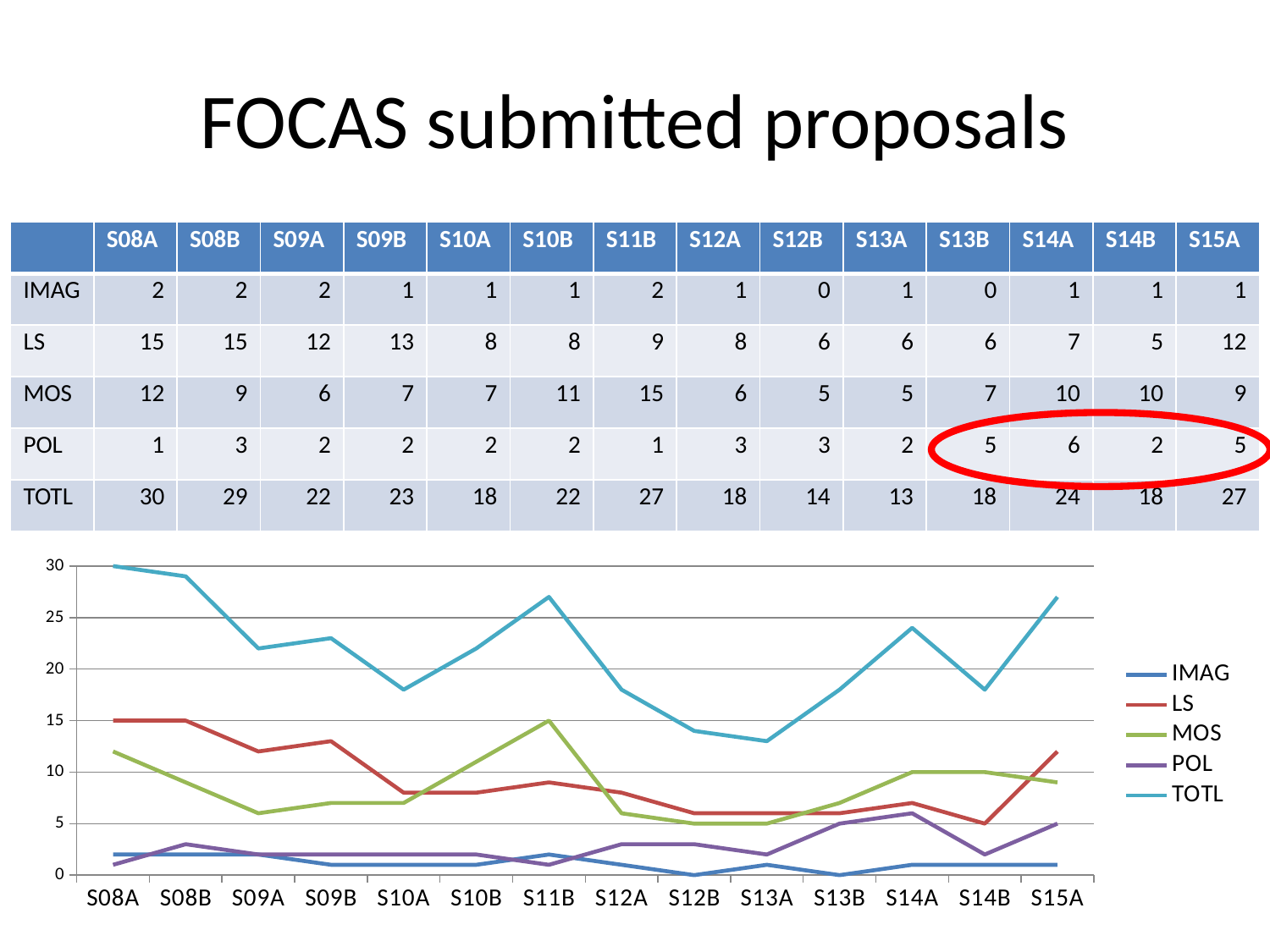
What is the POL value at S14A? 6 Is the TOTL value at S11B greater or less than 25? greater What is the difference between the TOTL values at S15A and S14B? 9 Does the TOTL series rise or fall from S08A to S10A? fall At S15A, which is larger, LS or MOS? LS How many semesters (categories) are plotted along the x axis of the chart? 14 What kind of chart is shown on the slide? line chart What is the TOTL value at S08A? 30 Which series is drawn in red on the chart? LS How many series does the chart's legend list? 5 At which semester does the MOS series reach its highest value? S11B What is the MOS value at S11B? 15